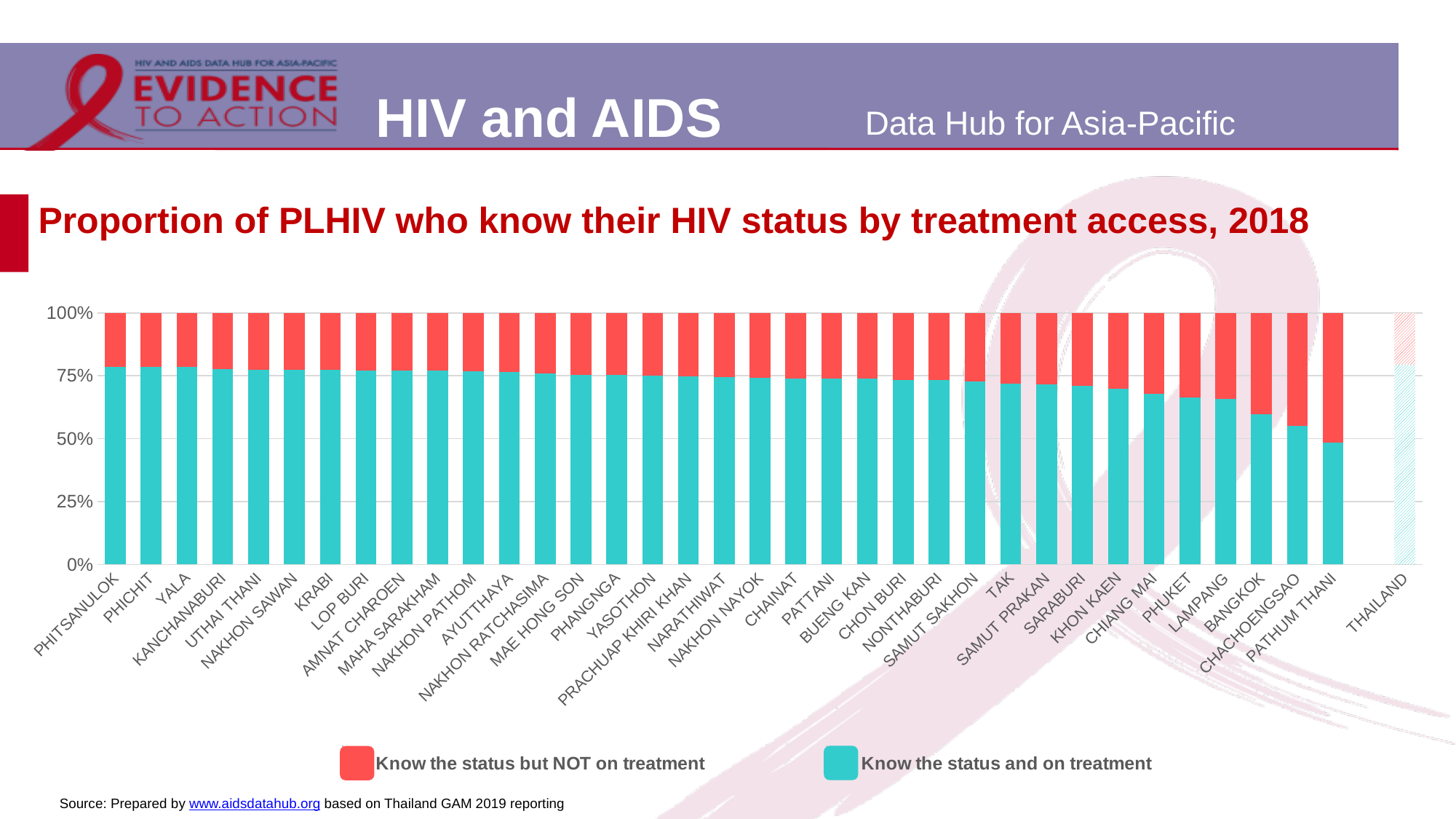
Is the value for 'Know the status and on treatment' for PHITSANULOK greater or less than 75%? greater Does the 'Know the status and on treatment' share rise or fall moving from PHITSANULOK to PATHUM THANI along the x axis? Fall How many categories are shown along the x axis of the chart? 36 Which category has the lowest proportion of PLHIV who know their status and are on treatment? PATHUM THANI How many series does the legend list? 2 Is the value for 'Know the status and on treatment' for CHIANG MAI greater or less than 75%? less Which has a larger 'Know the status and on treatment' share, BANGKOK or PATHUM THANI? BANGKOK Which category has the largest share of PLHIV who know their status but are NOT on treatment? PATHUM THANI What kind of chart is shown on the slide? Stacked bar chart What colour represents 'Know the status and on treatment' in the chart? Teal Is the value for 'Know the status and on treatment' for BANGKOK greater or less than 50%? greater